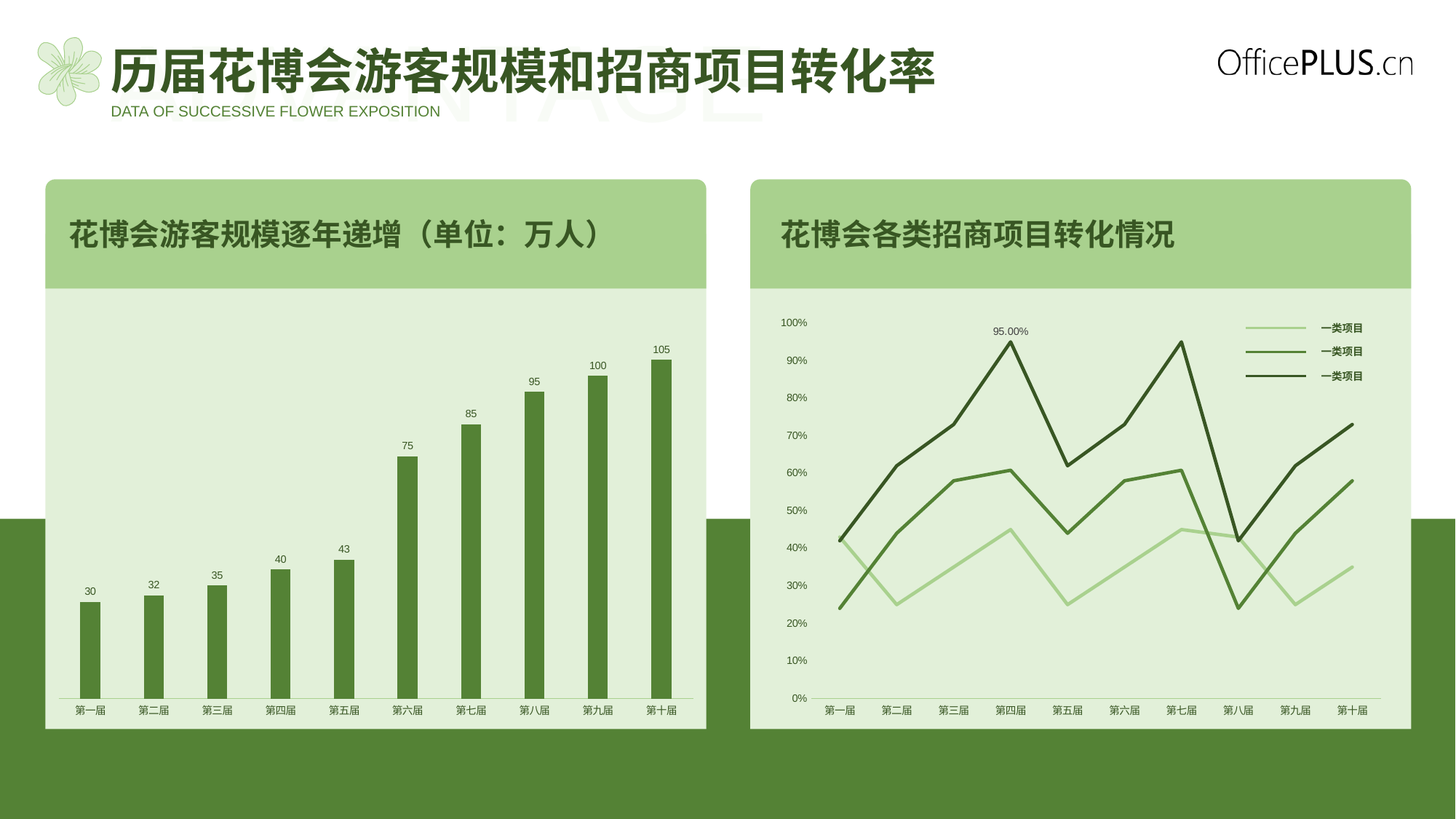
In the right chart (花博会各类招商项目转化情况), what is the data label shown at 第四届 on the darkest green line? 95.00% In the left chart (花博会游客规模逐年递增), which category has the lowest value? 第一届 In the left chart (花博会游客规模逐年递增), which is larger, the value for 第七届 or 第四届? 第七届 In the left chart (花博会游客规模逐年递增), which category has the highest value? 第十届 In the left chart (花博会游客规模逐年递增), do the values rise or fall from 第一届 to 第十届? Rise In the right chart (花博会各类招商项目转化情况), how many series does the legend list? 3 In the left chart (花博会游客规模逐年递增), what is the value for 第六届? 75 In the left chart (花博会游客规模逐年递增), what is the value for 第一届? 30 What kind of chart is the right chart (花博会各类招商项目转化情况)? Line chart In the left chart (花博会游客规模逐年递增), how many categories are shown on the x axis? 10 What kind of chart is the left chart (花博会游客规模逐年递增)? Bar chart In the left chart (花博会游客规模逐年递增), what is the difference between the values for 第十届 and 第五届? 62